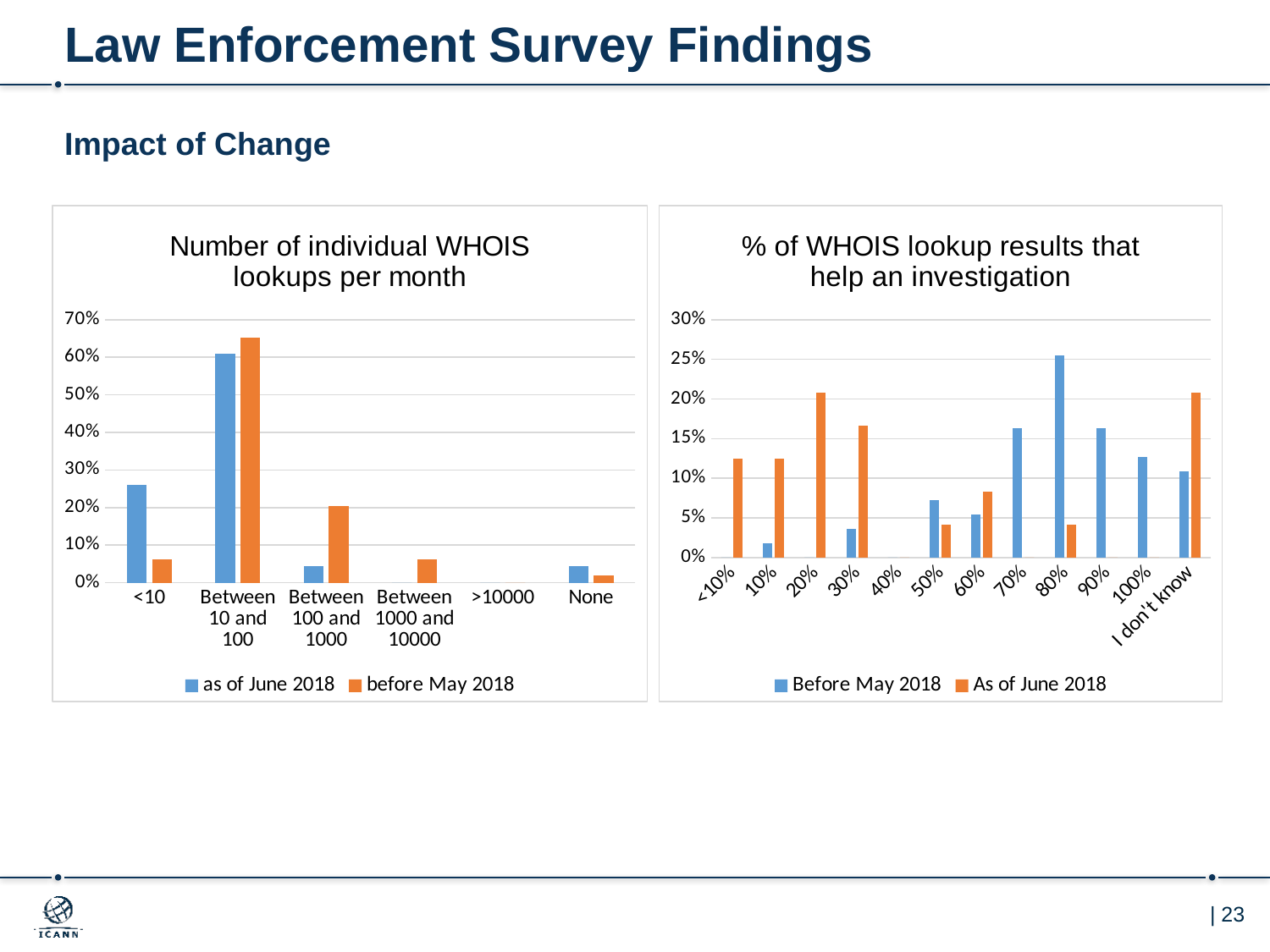
In the left chart, 'Number of individual WHOIS lookups per month', which category has the highest value for 'as of June 2018'? Between 10 and 100 In the right chart, '% of WHOIS lookup results that help an investigation', which is larger for '20%': 'Before May 2018' or 'As of June 2018'? As of June 2018 In the left chart, 'Number of individual WHOIS lookups per month', is the 'as of June 2018' value for '<10' greater or less than 20%? greater How many categories are shown on the x axis of the right chart, '% of WHOIS lookup results that help an investigation'? 12 How many categories are shown on the x axis of the left chart, 'Number of individual WHOIS lookups per month'? 6 In the right chart, '% of WHOIS lookup results that help an investigation', is the 'Before May 2018' value for '80%' greater or less than 20%? greater In the left chart, 'Number of individual WHOIS lookups per month', which is larger for '<10': 'as of June 2018' or 'before May 2018'? as of June 2018 In the left chart, 'Number of individual WHOIS lookups per month', is the 'before May 2018' value for 'Between 100 and 1000' greater or less than 10%? greater In the right chart, '% of WHOIS lookup results that help an investigation', which category has the highest value for 'Before May 2018'? 80% In the right chart, '% of WHOIS lookup results that help an investigation', which colour represents the 'As of June 2018' series? orange How many series does the legend of the right chart, '% of WHOIS lookup results that help an investigation', list? 2 What type of chart is the left chart, 'Number of individual WHOIS lookups per month'? bar chart